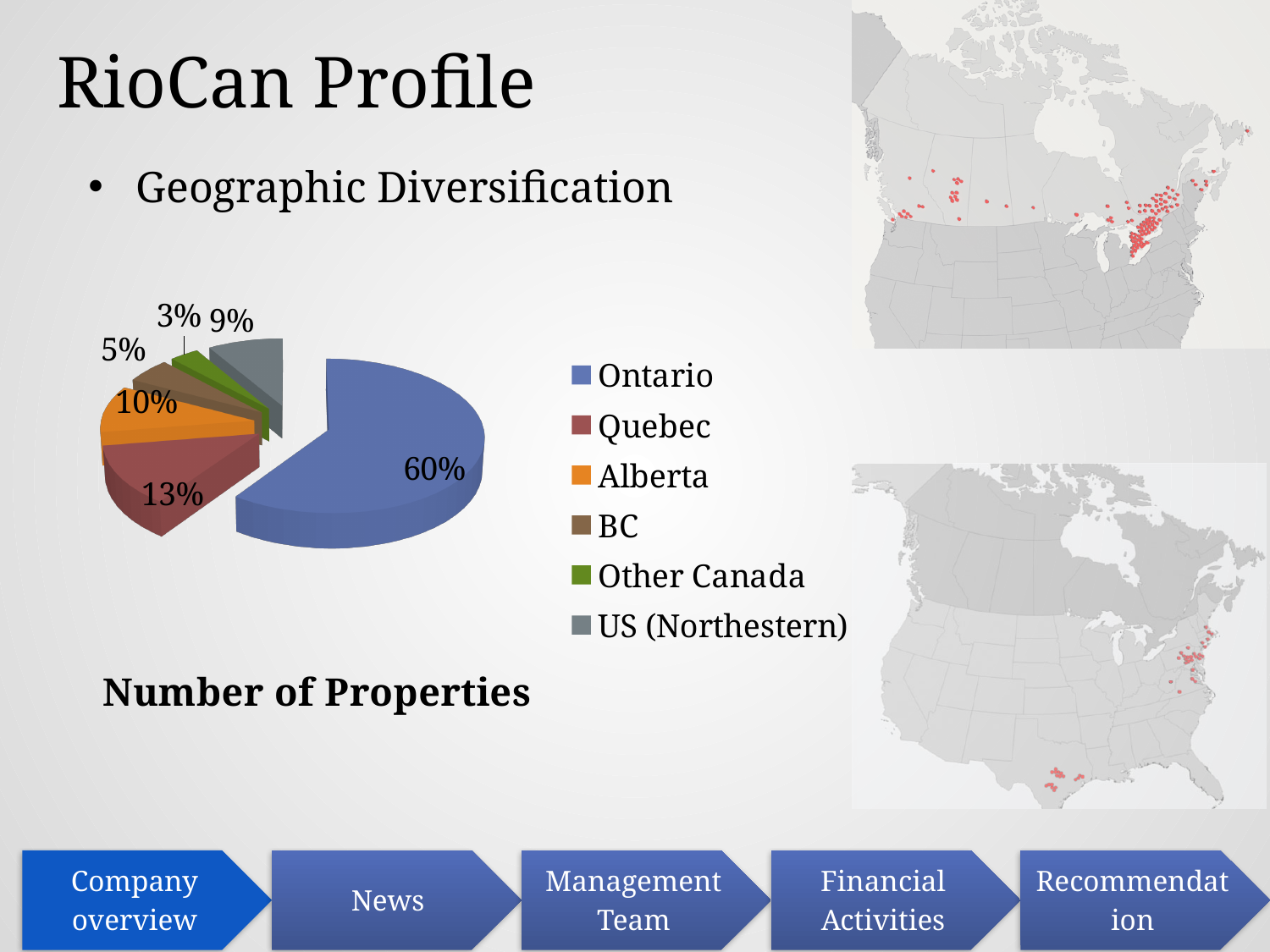
What share of the pie does Ontario represent? 60% Which is larger, the share for BC or the share for US (Northestern)? US (Northestern) What is the difference in percentage points between Ontario and Quebec? 47 What kind of chart is used to show the geographic diversification? Pie chart What percentage is shown for Alberta? 10% What is the title shown beneath the pie chart? Number of Properties How many regions are shown in the pie chart? 6 Which region has the largest slice of the pie? Ontario What percentage is shown for US (Northestern)? 9% What percentage is shown for Quebec? 13% What is the combined share of Alberta and BC? 15% Which region has the smallest slice of the pie? Other Canada